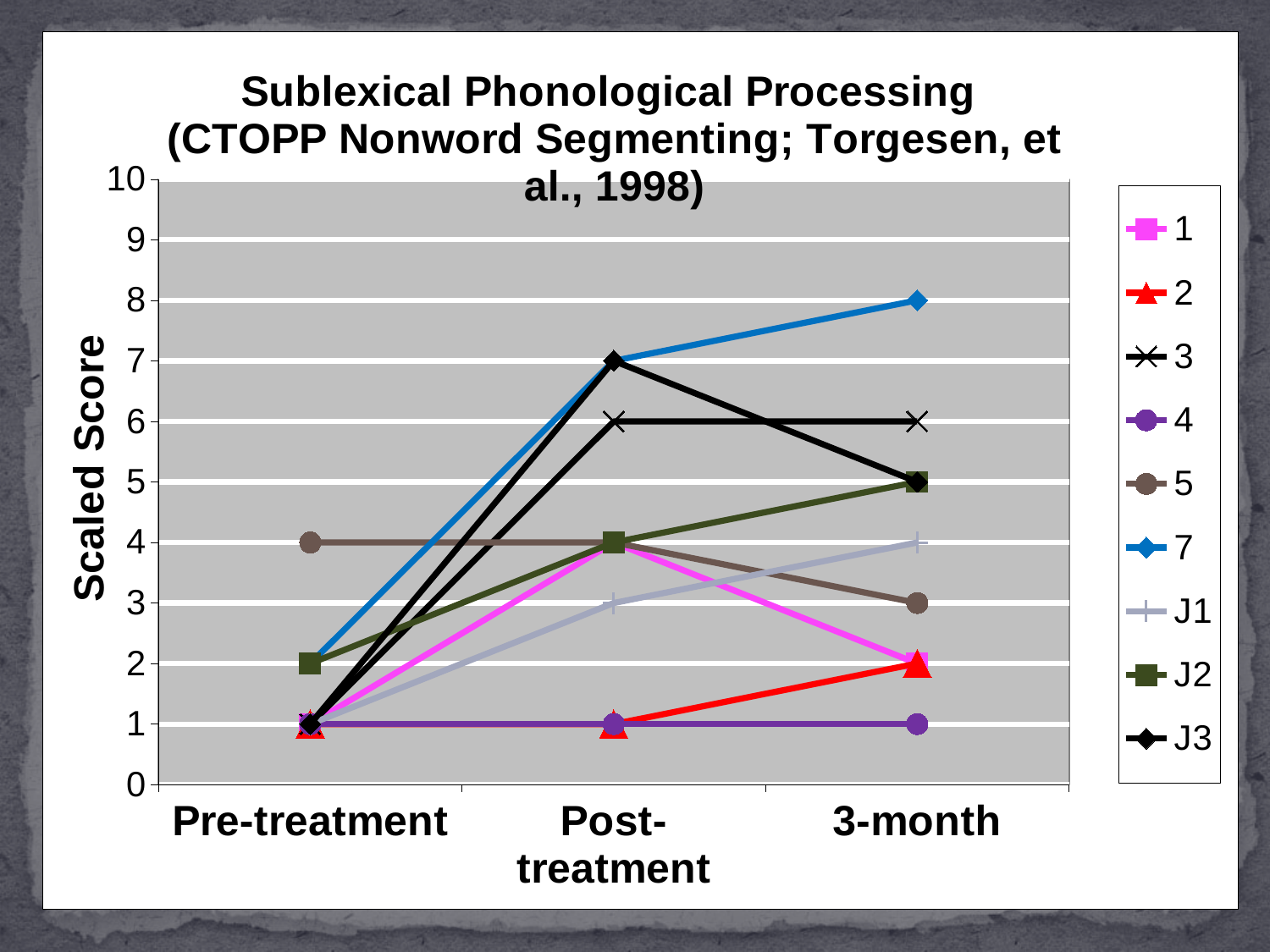
What is the value for series 5 at Pre-treatment? 4 What is the value for series 3 at 3-month? 6 What is the value for series J3 at Post-treatment? 7 How many time points are shown on the x axis? 3 At 3-month, which is larger: series 3 or series J3? 3 Which series has the lowest value at 3-month? 4 What is the difference between the 3-month and Pre-treatment values for series 7? 6 What is the value for series 7 at 3-month? 8 Which series has the highest value at 3-month? 7 How many series does the legend list? 9 What kind of chart is this? line chart Which series has the highest value at Pre-treatment? 5